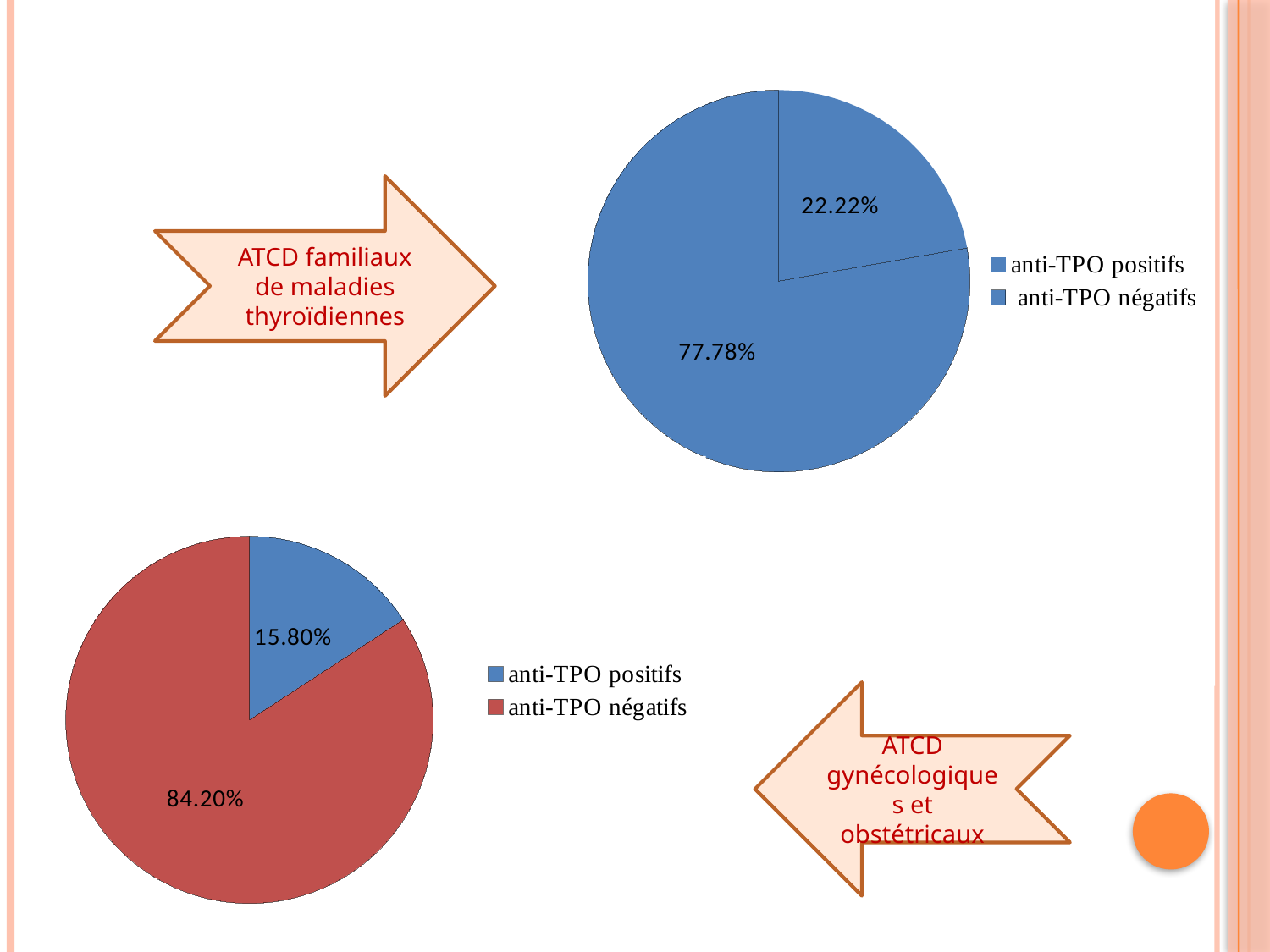
In the bottom pie chart, which category has the smallest slice? anti-TPO positifs In the bottom pie chart, what is the share for anti-TPO positifs? 15.80% In the bottom pie chart, what is the share for anti-TPO négatifs? 84.20% In the bottom pie chart, what colour is the anti-TPO négatifs slice? Red In the bottom pie chart, which category has the largest slice? anti-TPO négatifs How many slices does the bottom pie chart have? 2 In the top pie chart, what is the value of the largest slice? 77.78% In the top pie chart, what is the difference in percentage points between the two slices? 55.56 In the top pie chart, what is the value of the smallest slice? 22.22% How many entries does the legend of the top pie chart list? 2 In the bottom pie chart, what is the difference in percentage points between anti-TPO négatifs and anti-TPO positifs? 68.40 What kind of chart is the top chart on the slide? Pie chart